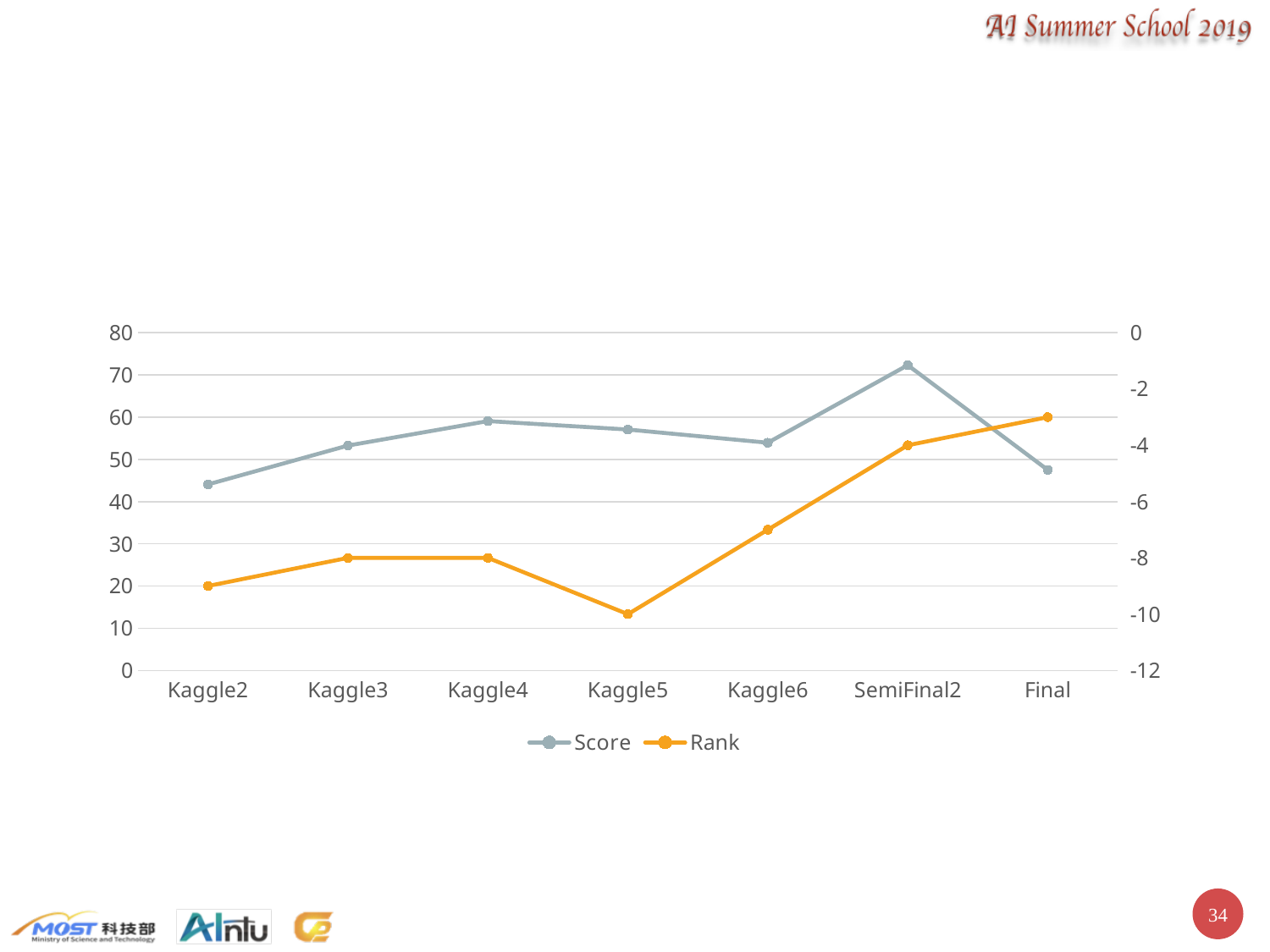
What kind of chart is shown on the slide? line chart Which has the higher Score, Kaggle3 or Kaggle4? Kaggle4 What are the two series named in the legend? Score and Rank Which category has the lowest (most negative) Rank value? Kaggle5 How many categories are shown on the x axis? 7 Which category has the highest Score? SemiFinal2 Which category has the lowest Score? Kaggle2 Is the Rank value for Kaggle6 greater or less than -6? less Does the Score rise or fall from Kaggle2 to Kaggle4? rise Is the Score for SemiFinal2 greater or less than 70? greater Is the Score for Kaggle2 greater or less than 50? less How many series does the legend list? 2